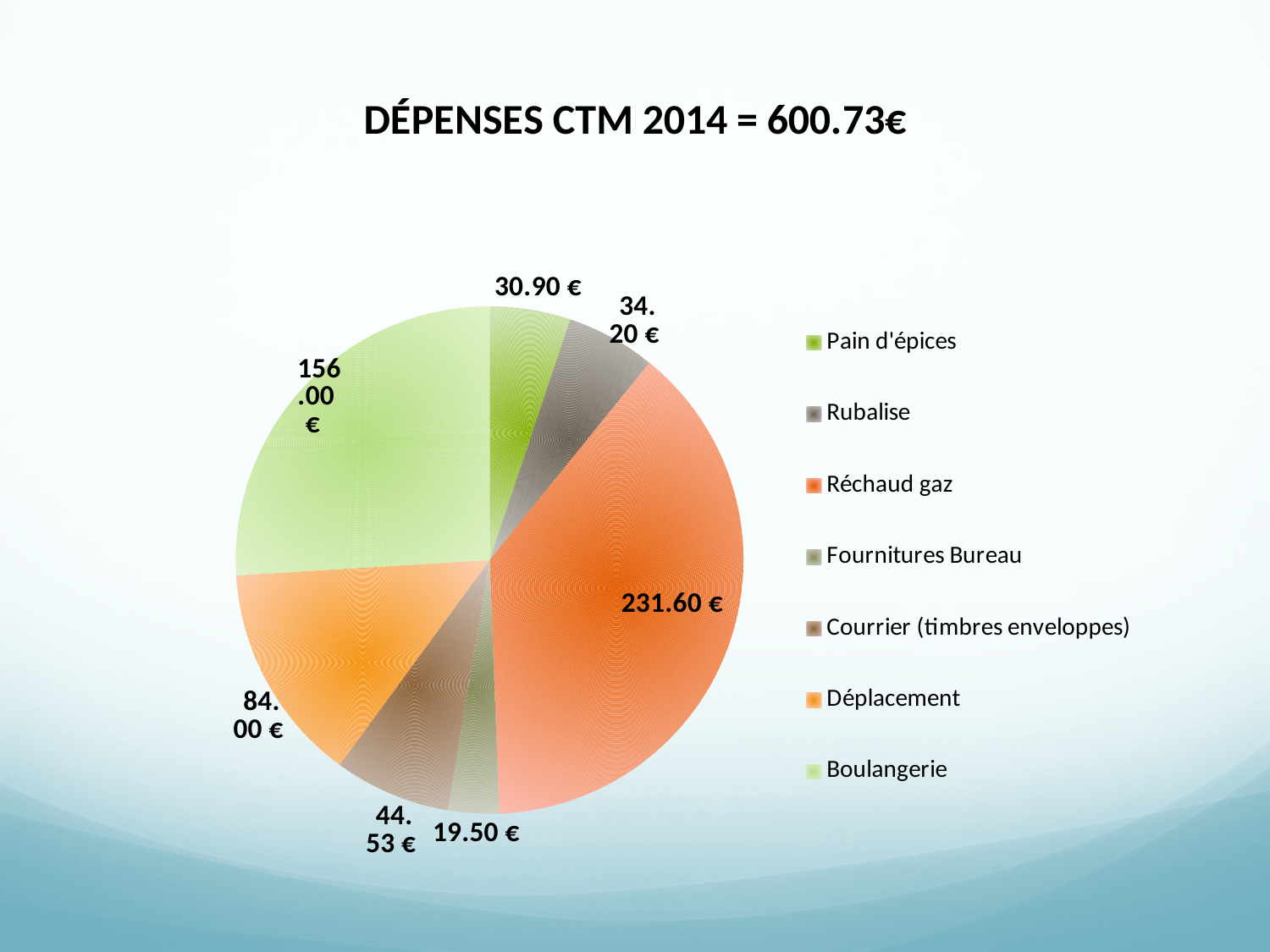
What is the value for Fournitures Bureau? 19.50 € What type of chart is shown on the slide? Pie chart What is the value for Réchaud gaz? 231.60 € Which is larger, the value for Rubalise or the value for Pain d'épices? Rubalise Which category has the largest slice of the pie? Réchaud gaz What is the title of the chart? DÉPENSES CTM 2014 = 600.73€ What is the difference between the values for Boulangerie and Déplacement? 72.00 € Which category has the smallest slice of the pie? Fournitures Bureau What is the value for Courrier (timbres enveloppes)? 44.53 € How many categories does the pie chart have? 7 What is the value for Boulangerie? 156.00 € Which legend entry is listed last? Boulangerie